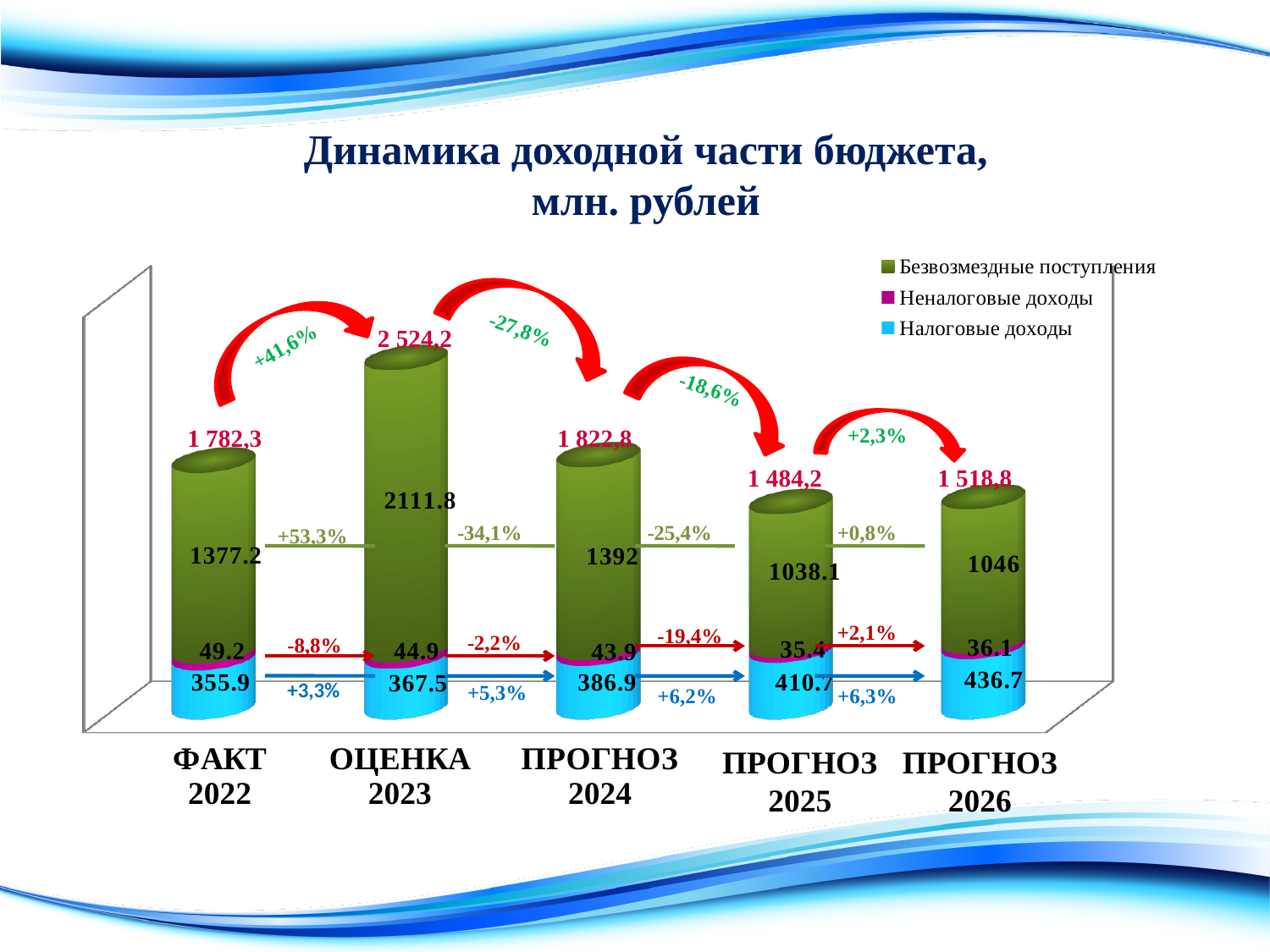
How many categories are shown on the x axis? 5 Which category has the lowest value for Неналоговые доходы? ПРОГНОЗ 2025 Which category has the highest total? ОЦЕНКА 2023 What is the value of Безвозмездные поступления for ОЦЕНКА 2023? 2111.8 How many series does the legend list? 3 What is the difference between Налоговые доходы for ПРОГНОЗ 2024 and ОЦЕНКА 2023? 19.4 What is the total shown above the bar for ПРОГНОЗ 2025? 1 484,2 What kind of chart is shown? Stacked bar chart What is the value of Налоговые доходы for ПРОГНОЗ 2026? 436.7 Do the values for Налоговые доходы rise or fall from ФАКТ 2022 to ПРОГНОЗ 2026? Rise What is the value of Неналоговые доходы for ФАКТ 2022? 49.2 Which is larger: Безвозмездные поступления for ПРОГНОЗ 2024 or for ФАКТ 2022? ПРОГНОЗ 2024